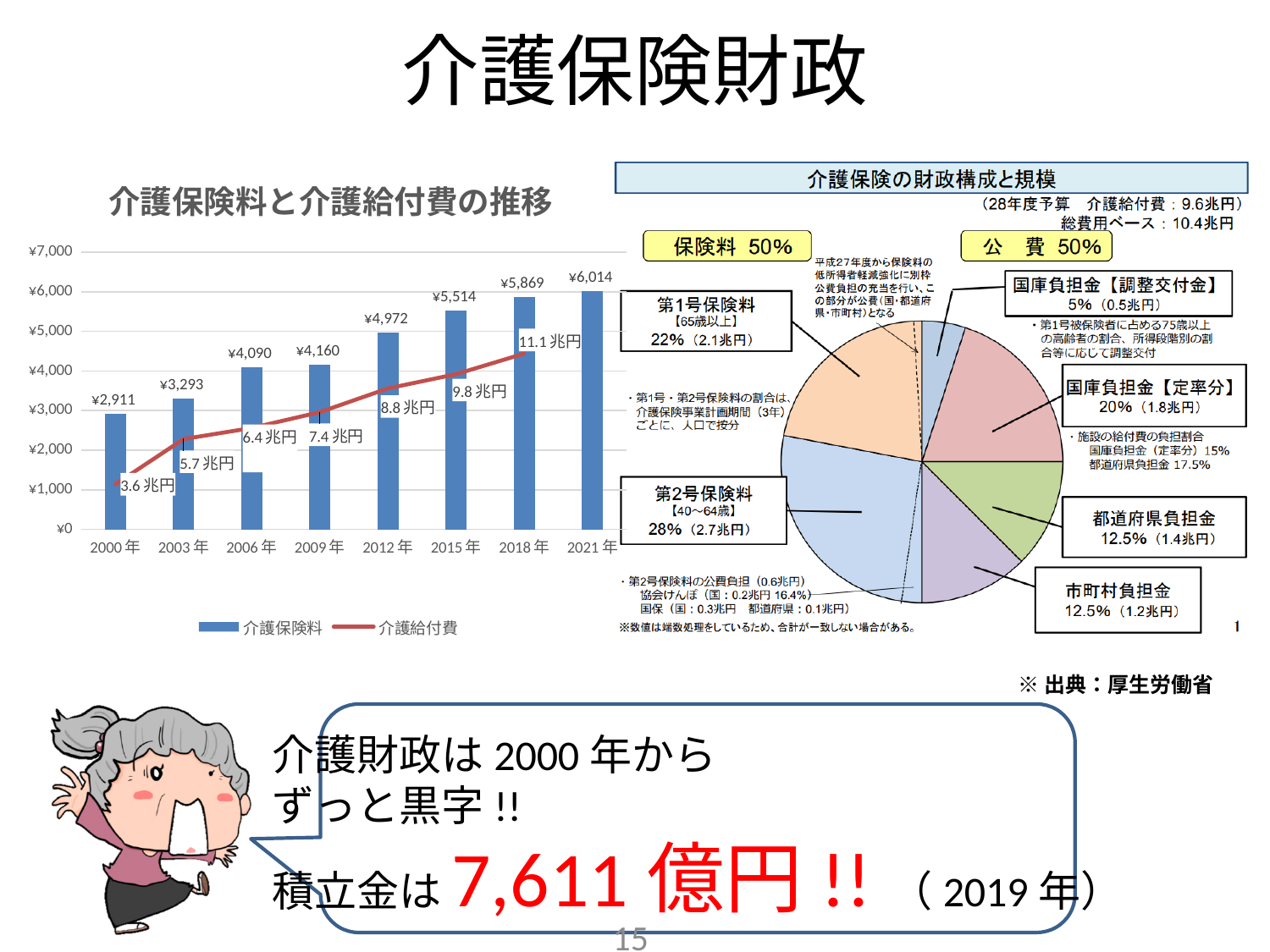
In the chart titled 介護保険料と介護給付費の推移, what is the value of 介護給付費 for 2012年? 8.8兆円 In the chart titled 介護保険料と介護給付費の推移, does 介護給付費 rise or fall from 2000年 to 2018年? rise What kind of chart is the one titled 介護保険の財政構成と規模? pie chart In the chart titled 介護保険料と介護給付費の推移, what is the value of 介護保険料 for 2021年? ¥6,014 In the chart titled 介護保険料と介護給付費の推移, how many years are shown on the x axis? 8 In the pie chart titled 介護保険の財政構成と規模, what is the amount for 国庫負担金【定率分】? 1.8兆円 In the pie chart titled 介護保険の財政構成と規模, what share is 第2号保険料? 28% In the chart titled 介護保険料と介護給付費の推移, how many series does the legend list? 2 In the pie chart titled 介護保険の財政構成と規模, which slice is the smallest? 国庫負担金【調整交付金】 In the chart titled 介護保険料と介護給付費の推移, which year has the lowest 介護保険料? 2000年 In the chart titled 介護保険料と介護給付費の推移, what is the difference in 介護保険料 between 2018年 and 2015年? ¥355 In the chart titled 介護保険料と介護給付費の推移, is the 介護保険料 for 2009年 greater or less than ¥4,000? greater